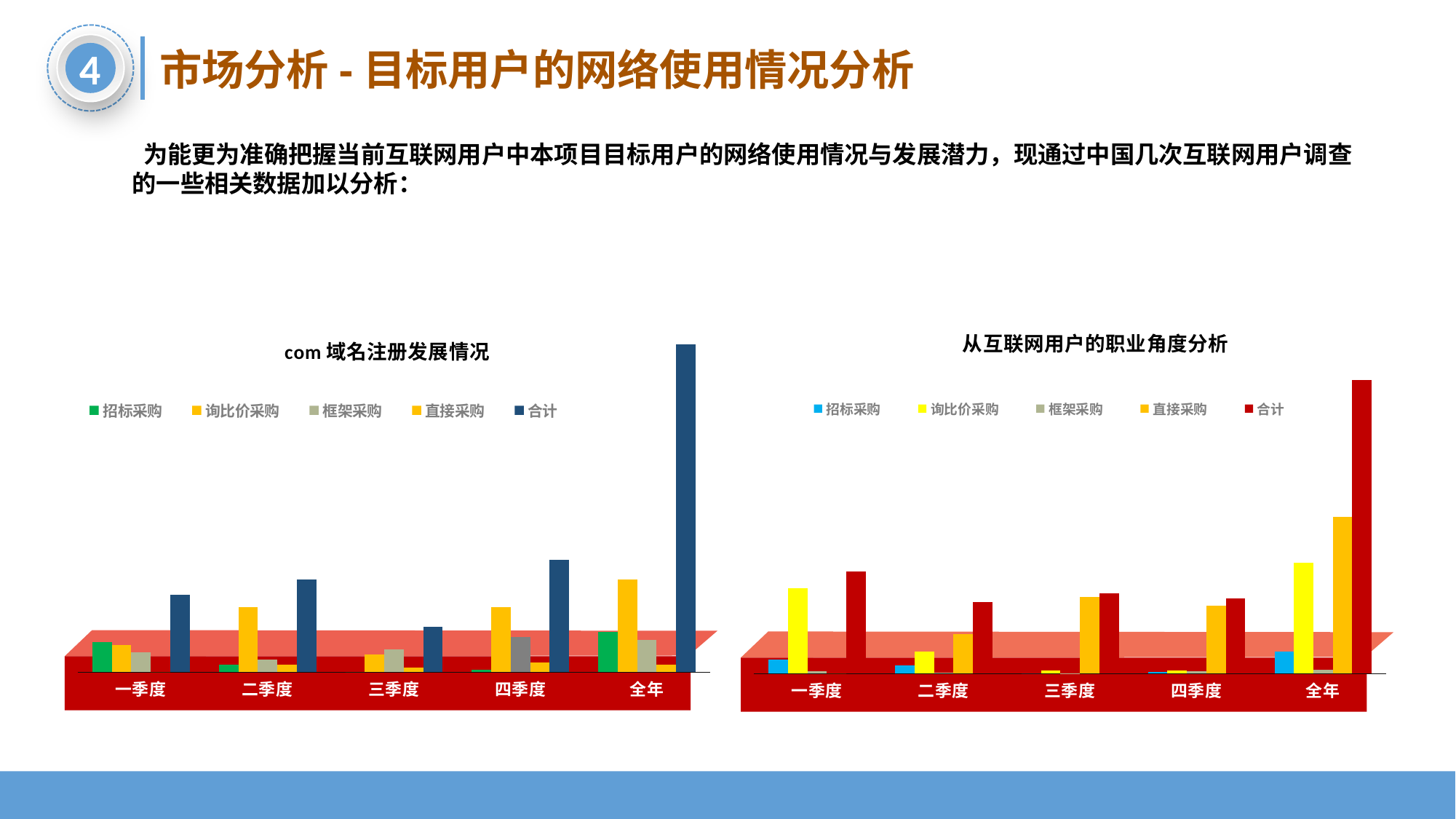
In the right chart "从互联网用户的职业角度分析", how many categories are shown on the x axis? 5 What kind of chart is the left chart titled "com 域名注册发展情况"? bar chart How many series does the legend of the right chart "从互联网用户的职业角度分析" list? 5 In the left chart "com 域名注册发展情况", which category has the lowest 合计 bar? 三季度 What kind of chart is the right chart titled "从互联网用户的职业角度分析"? bar chart In the left chart "com 域名注册发展情况", how many categories are shown on the x axis? 5 What is the title of the right chart on the slide? 从互联网用户的职业角度分析 In the right chart "从互联网用户的职业角度分析", which category has the highest 合计 bar? 全年 How many series does the legend of the left chart "com 域名注册发展情况" list? 5 In the right chart "从互联网用户的职业角度分析", which is larger for 询比价采购: 一季度 or 全年? 全年 In the left chart "com 域名注册发展情况", which category has the highest 合计 bar? 全年